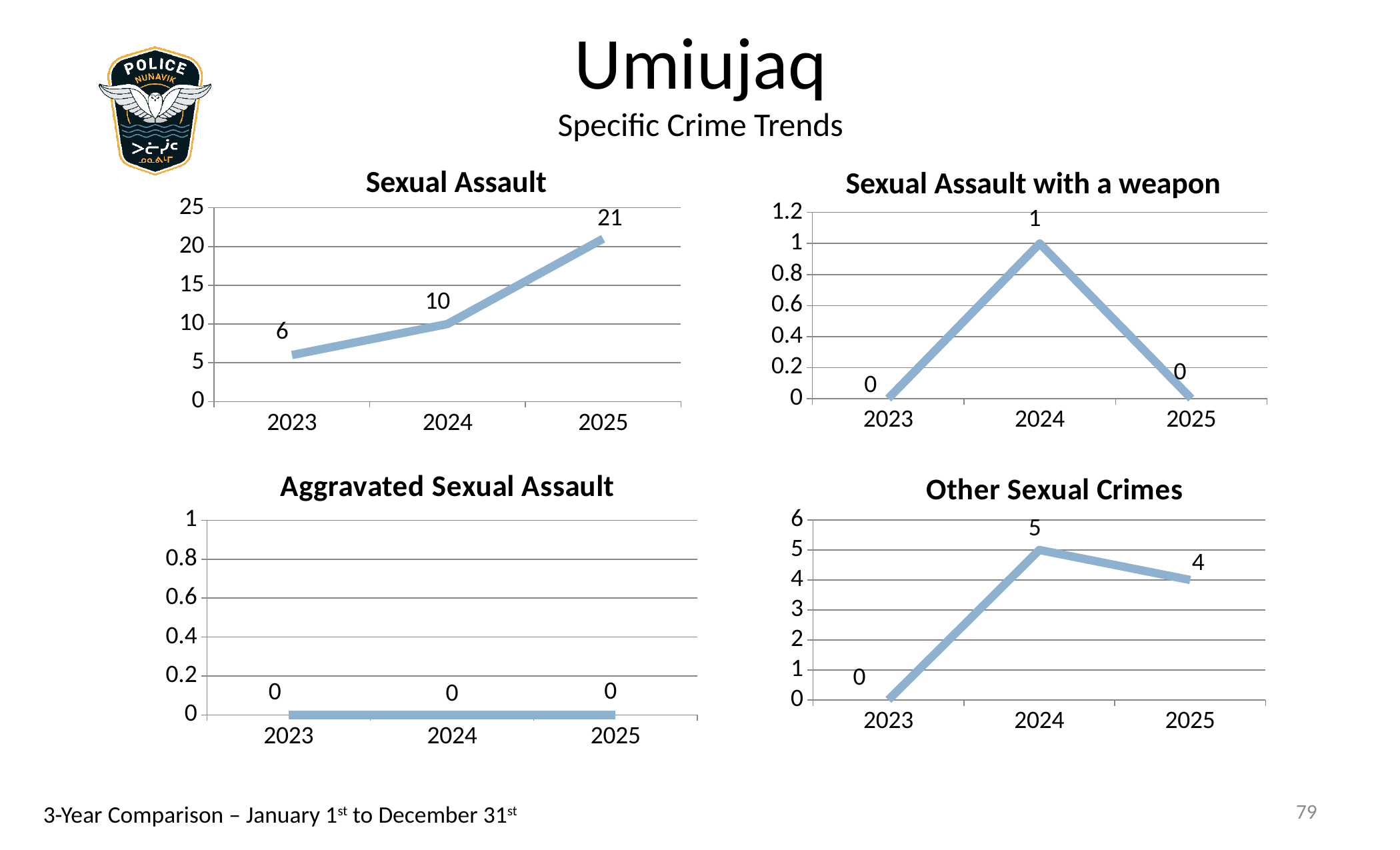
In the Sexual Assault chart, what is the difference between the 2025 and 2024 values? 11 In the Sexual Assault chart, which year has the highest value? 2025 In the Sexual Assault chart, what is the value for 2023? 6 In the Other Sexual Crimes chart, which is larger, the value for 2024 or the value for 2025? 2024 In the Other Sexual Crimes chart, what is the value for 2025? 4 How many years are plotted in the Other Sexual Crimes chart? 3 In the Sexual Assault chart, what is the value for 2025? 21 What kind of chart is the Sexual Assault chart? line chart In the Sexual Assault chart, do the values rise or fall from 2023 to 2025? rise In the Aggravated Sexual Assault chart, what is the value for 2024? 0 In the Sexual Assault with a weapon chart, what is the value for 2024? 1 In the Sexual Assault with a weapon chart, which year has the highest value? 2024